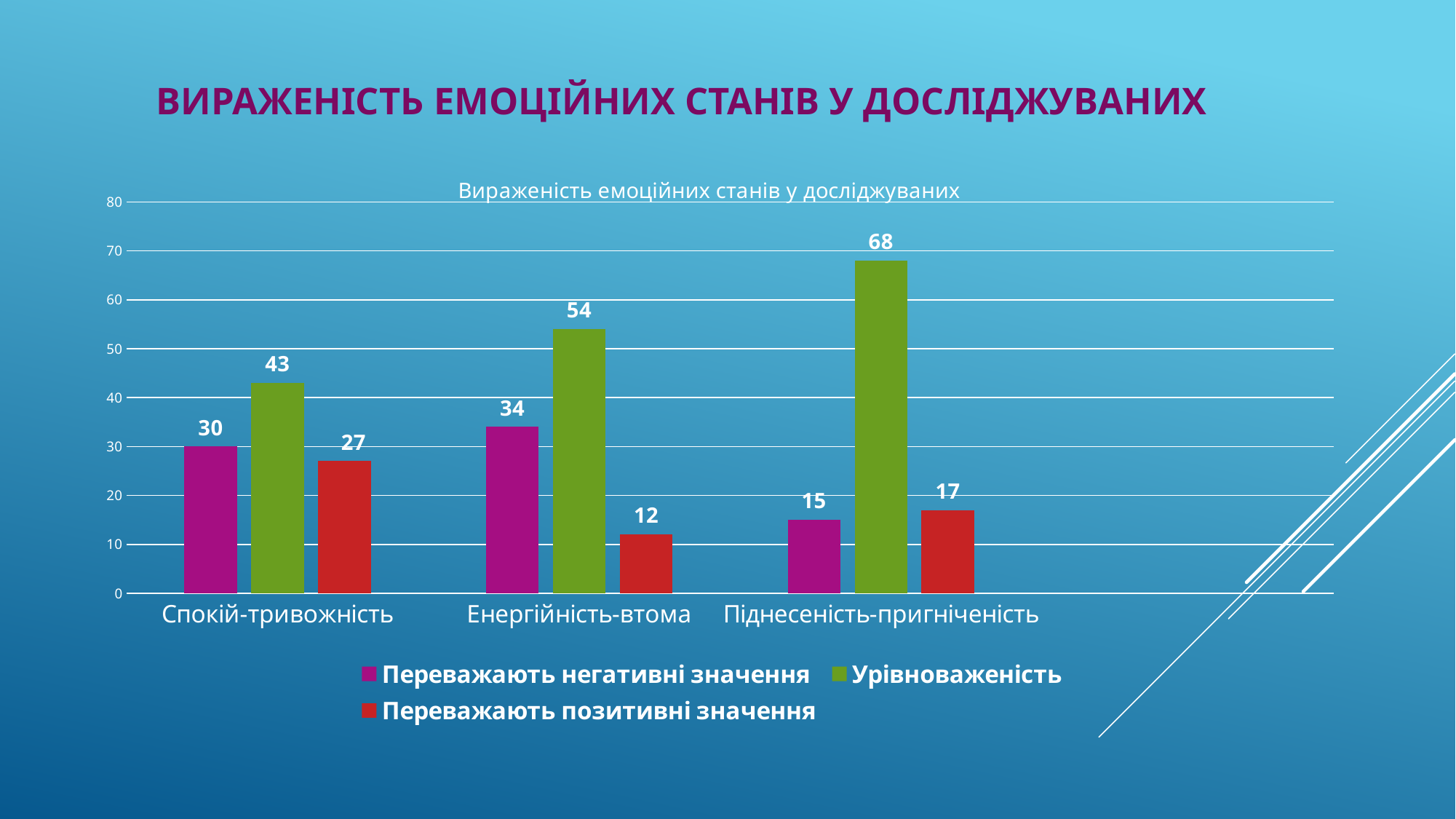
Which is larger for "Спокій-тривожність": "Переважають негативні значення" or "Переважають позитивні значення"? Переважають негативні значення What colour are the bars for "Урівноваженість"? Green What is the value of "Урівноваженість" for "Спокій-тривожність"? 43 How many series does the legend list? 3 What kind of chart is shown on the slide? Bar chart What is the difference between "Урівноваженість" and "Переважають негативні значення" for "Енергійність-втома"? 20 Which category has the lowest value for "Переважають позитивні значення"? Енергійність-втома What is the value of "Переважають позитивні значення" for "Енергійність-втома"? 12 How many categories are shown on the x axis? 3 Which category has the highest value for "Урівноваженість"? Піднесеність-пригніченість What is the value of "Переважають негативні значення" for "Піднесеність-пригніченість"? 15